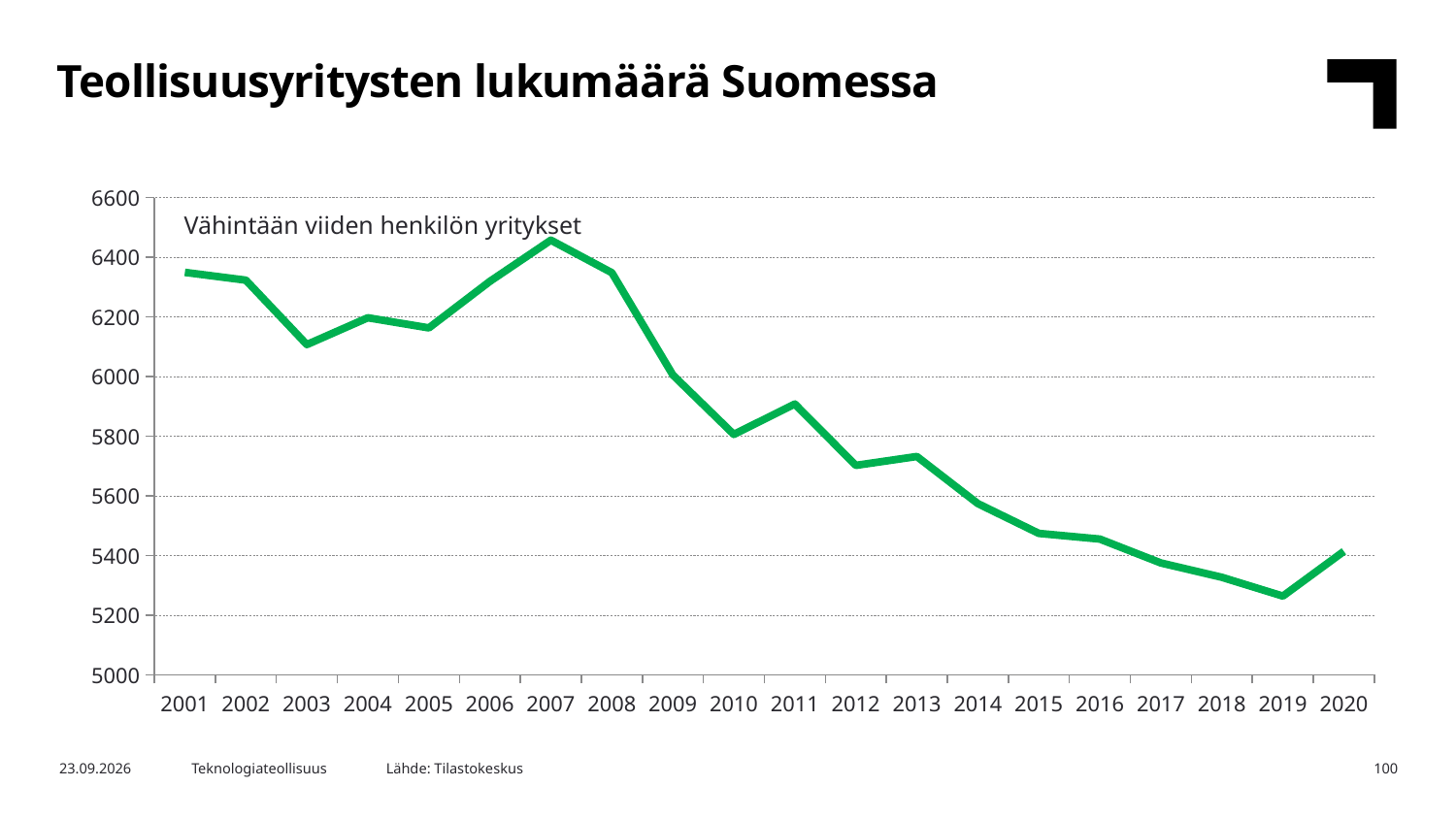
How many years are plotted on the x axis? 20 Is the value for 2007 greater or less than 6400? greater Which year has the larger value, 2010 or 2011? 2011 Is the value for 2012 greater or less than 5800? less What is the title of the chart? Teollisuusyritysten lukumäärä Suomessa In which year is the number of industrial companies highest? 2007 In which year is the number of industrial companies lowest? 2019 What kind of chart is shown on the slide? line chart Is the value for 2003 greater or less than 6000? greater Overall, do the values rise or fall from 2001 to 2020? fall Which year has the larger value, 2001 or 2020? 2001